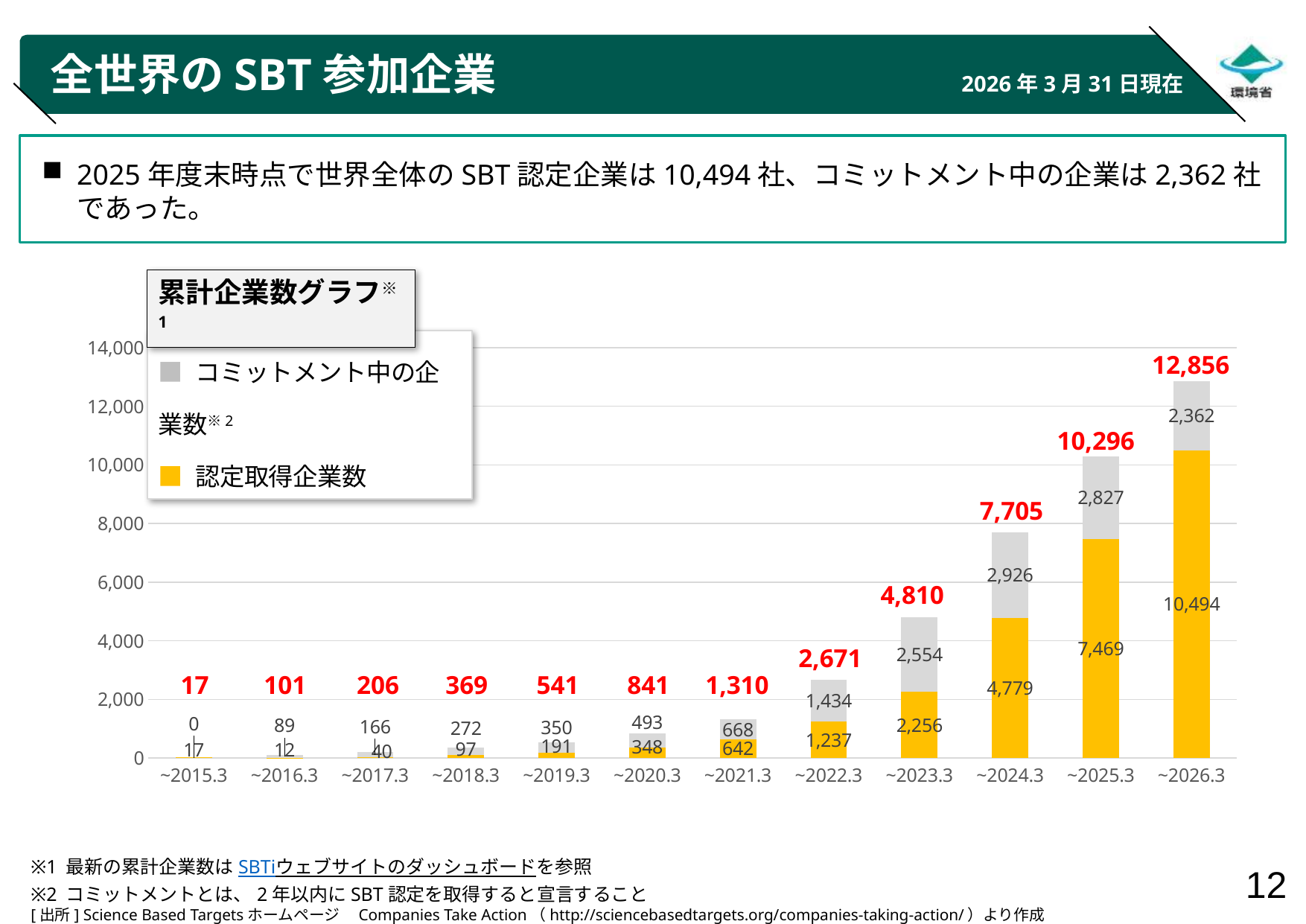
How many categories (time points) are shown on the x axis of the chart? 12 What is the value of コミットメント中の企業数 for ~2024.3? 2,926 Which is larger for ~2025.3: 認定取得企業数 or コミットメント中の企業数? 認定取得企業数 Which colour represents 認定取得企業数 in the chart? yellow How many series does the chart legend list? 2 What type of chart is shown on the slide? stacked bar chart What is the total shown above the stacked bar for ~2023.3? 4,810 What is the value of 認定取得企業数 for ~2026.3? 10,494 What is the difference between the 認定取得企業数 values for ~2026.3 and ~2025.3? 3,025 Which category has the lowest total number of companies? ~2015.3 Do the total values rise or fall from ~2015.3 to ~2026.3? rise Which category has the highest total number of companies? ~2026.3